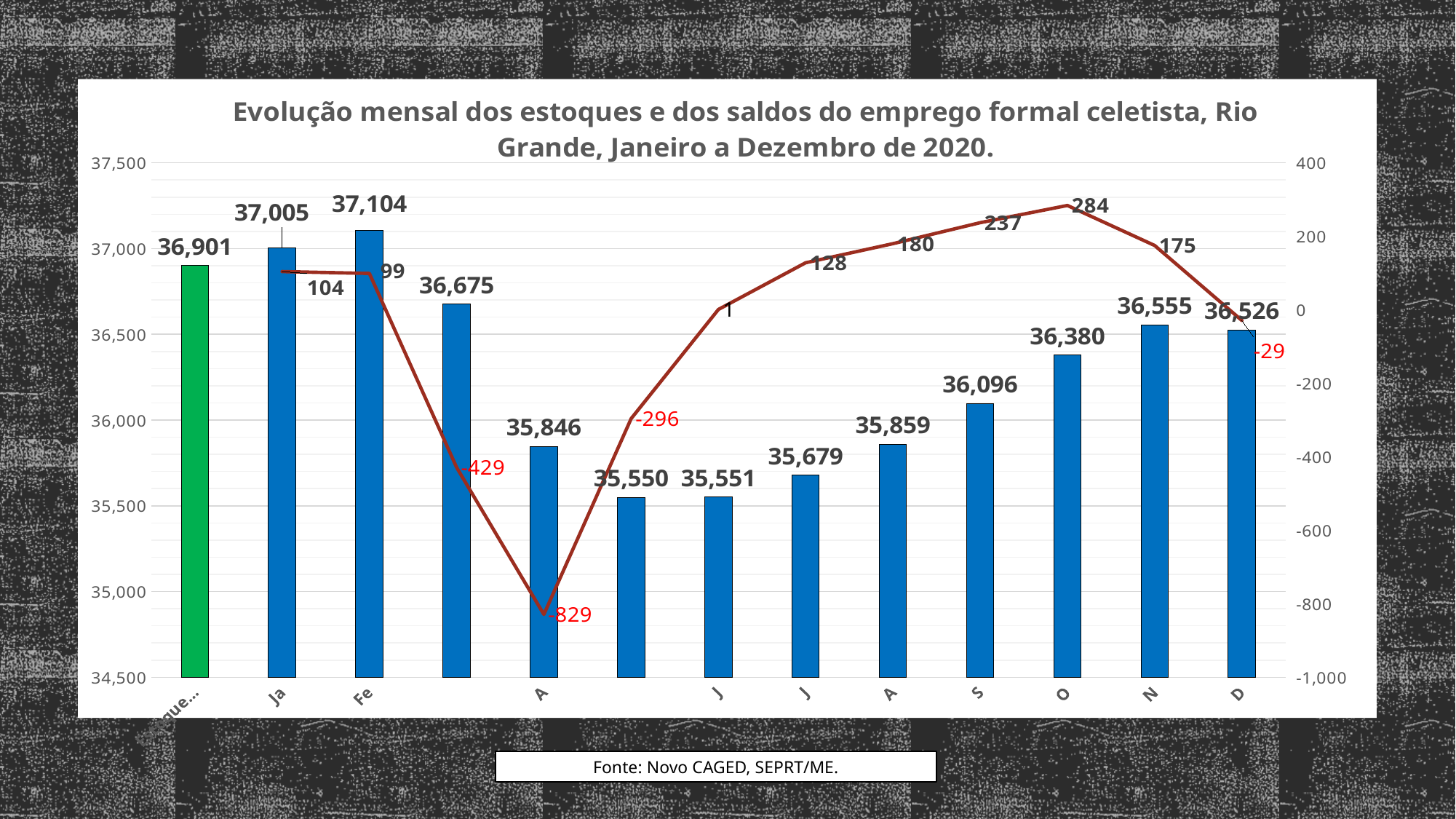
What is the difference between the bars for "Fe" and "Ja"? 99 What is the lowest value shown on the line? -829 What kind of chart is shown on the slide? A combined bar and line chart What is the value of the bar for "Fe"? 37,104 What is the value of the bar for "Ja"? 37,005 Which bar is taller, "S" or "O"? O What is the value of the line at "O"? 284 What is the value of the bar for "D"? 36,526 What is the difference between the bars for "N" and "D"? 29 Which category has the highest bar? Fe What is the value of the lowest bar in the chart? 35,550 How many bars are plotted in the chart? 13